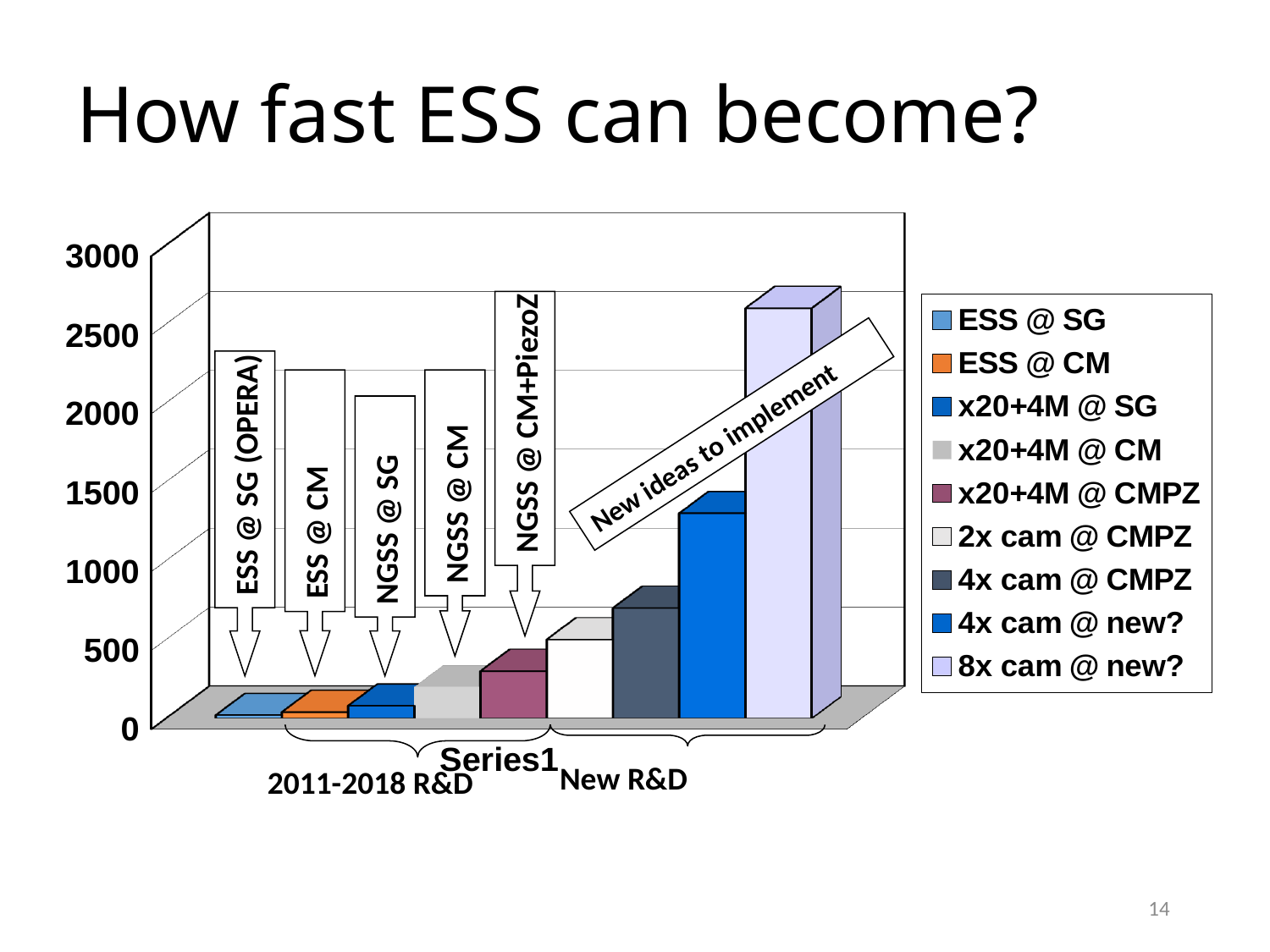
Is the value for 8x cam @ new? greater or less than 2000? greater What kind of chart is shown on the slide? bar chart Is the value for 4x cam @ new? greater or less than 2000? less How many entries does the chart legend list? 9 Is the value for 4x cam @ new? greater or less than 1000? greater Do the bar values rise or fall from left to right across the chart? rise Which is larger, the bar for 4x cam @ new? or the bar for 8x cam @ new?? 8x cam @ new? What is the title of the slide containing the chart? How fast ESS can become? Which legend entry has the shortest bar? ESS @ SG How many bars are plotted in the chart? 9 Which legend entry has the tallest bar? 8x cam @ new?